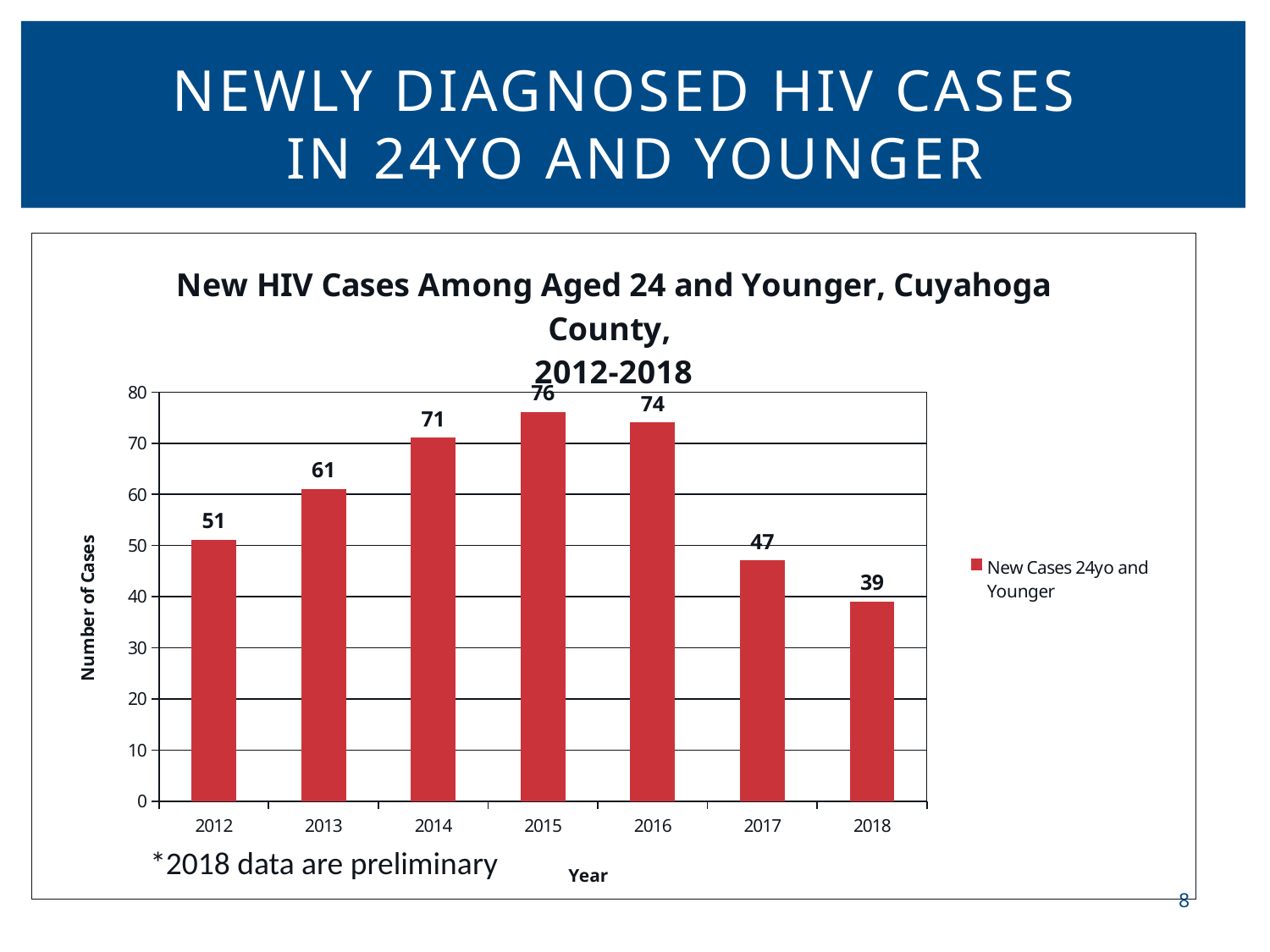
Which year has the highest number of new HIV cases among those aged 24 and younger? 2015 Which year had more new HIV cases among those aged 24 and younger, 2013 or 2017? 2013 What is the number of new HIV cases among those aged 24 and younger in 2015? 76 What kind of chart is shown on the slide? Bar chart Is the value for 2014 greater or less than 60? greater How many years are shown on the x axis of the chart? 7 What is the difference in new HIV cases between 2015 and 2018? 37 Do the values rise or fall from 2016 to 2018? Fall What is the number of new HIV cases among those aged 24 and younger in 2018? 39 Which year has the lowest number of new HIV cases among those aged 24 and younger? 2018 How many series does the chart legend list? 1 What is the number of new HIV cases among those aged 24 and younger in 2012? 51